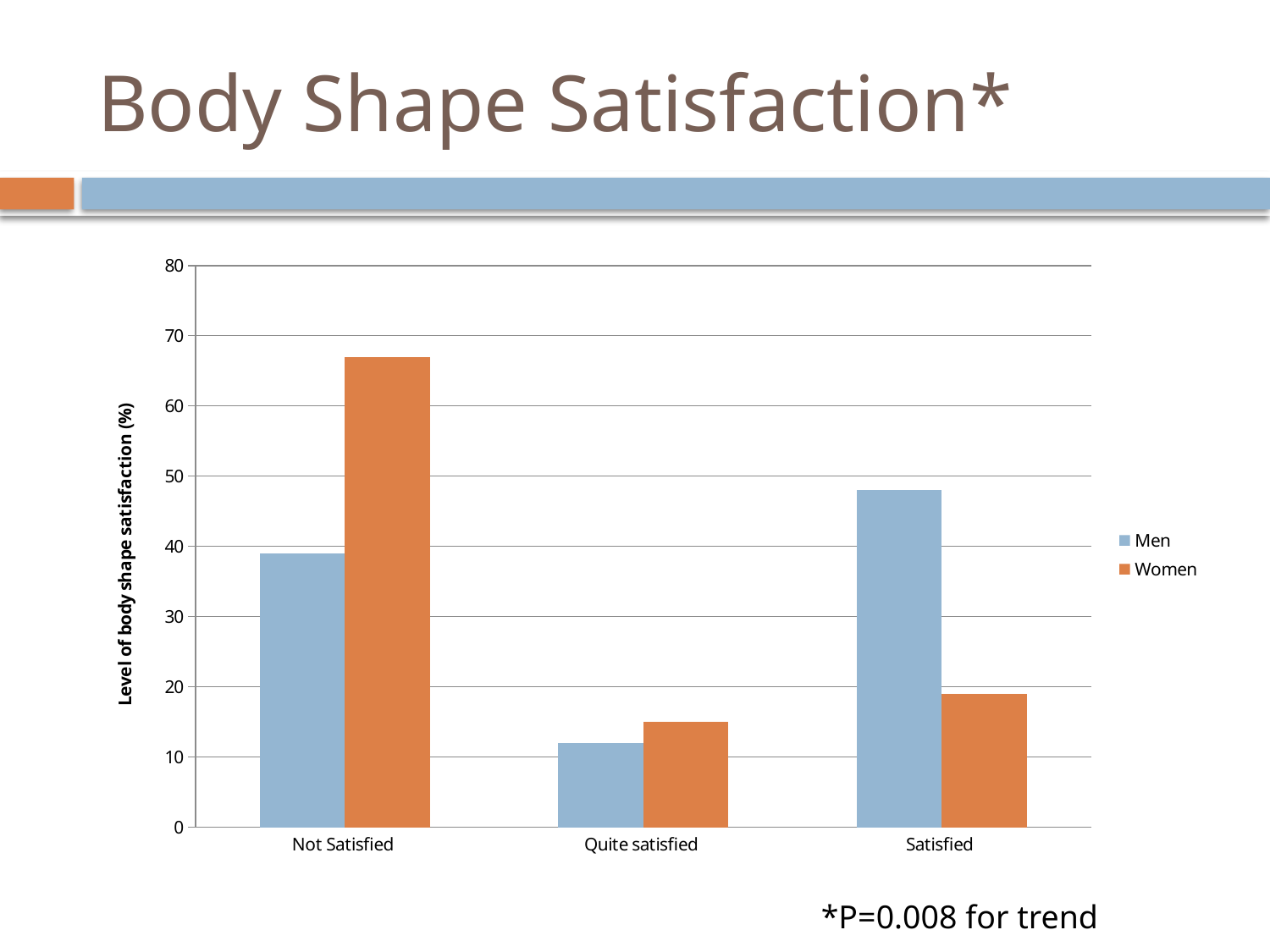
Is the value for Women in the Not Satisfied category greater or less than 60? greater Which category has the lowest value for Men? Quite satisfied How many categories are shown on the x axis? 3 What kind of chart is shown on the slide? bar chart Which category has the highest value for Men? Satisfied Which category has the lowest value for Women? Quite satisfied For Not Satisfied, which series has the larger value, Men or Women? Women What is the label of the y axis? Level of body shape satisfaction (%) Which category has the highest value for Women? Not Satisfied Is the value for Men in the Satisfied category greater or less than 50? less For Satisfied, which series has the larger value, Men or Women? Men How many series does the legend list? 2